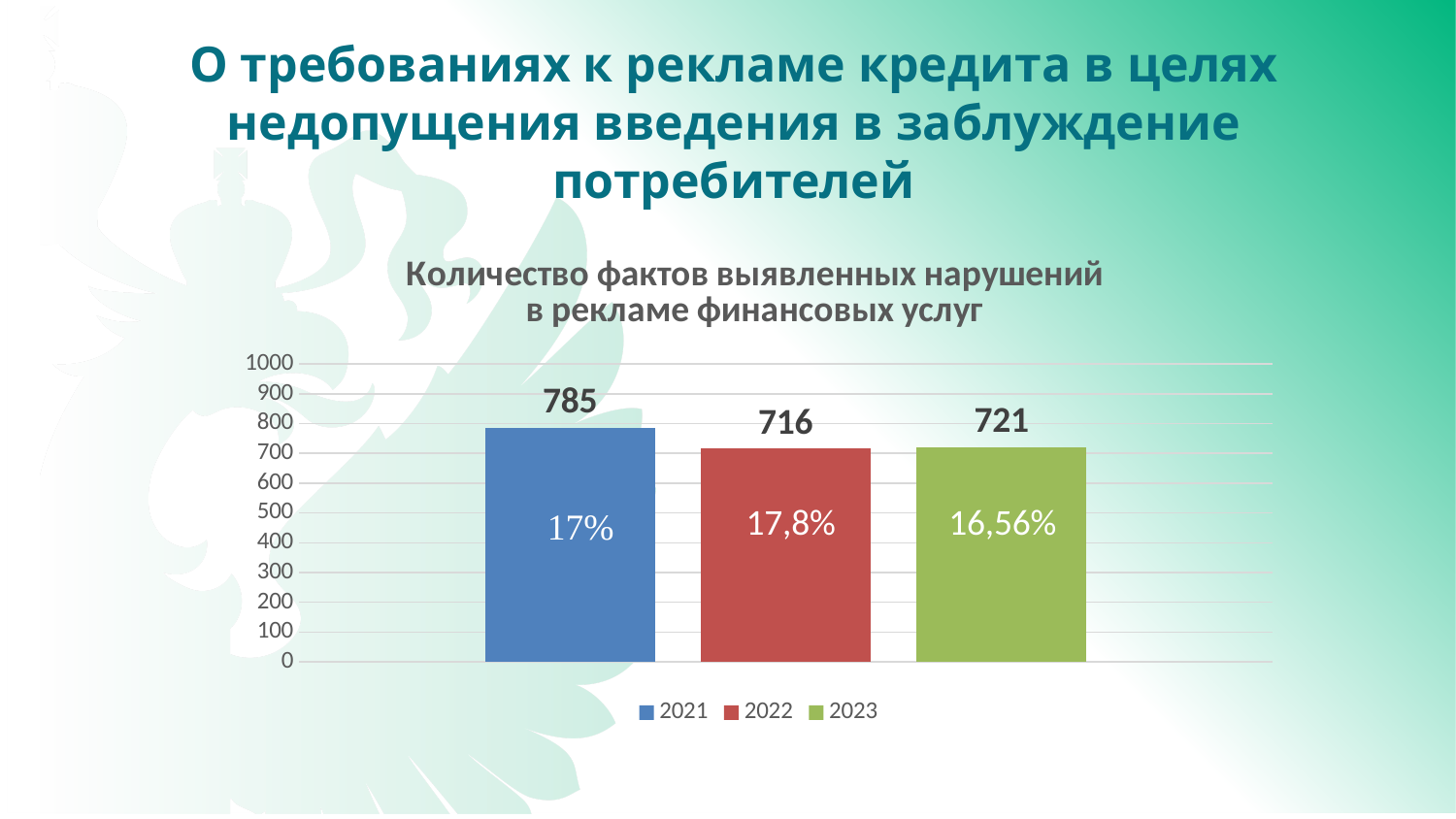
What is the value for 2022? 716 Is the value for 2022 greater or less than 800? less How many series does the legend list? 3 What is the value for 2023? 721 Which year has the lowest value? 2022 What percentage label is printed inside the bar for 2023? 16,56% Which year has the highest value? 2021 What is the difference between the values for 2021 and 2022? 69 What is the difference between the values for 2023 and 2022? 5 Which is larger, the value for 2021 or the value for 2023? 2021 What is the value for 2021? 785 What kind of chart is shown on the slide? bar chart